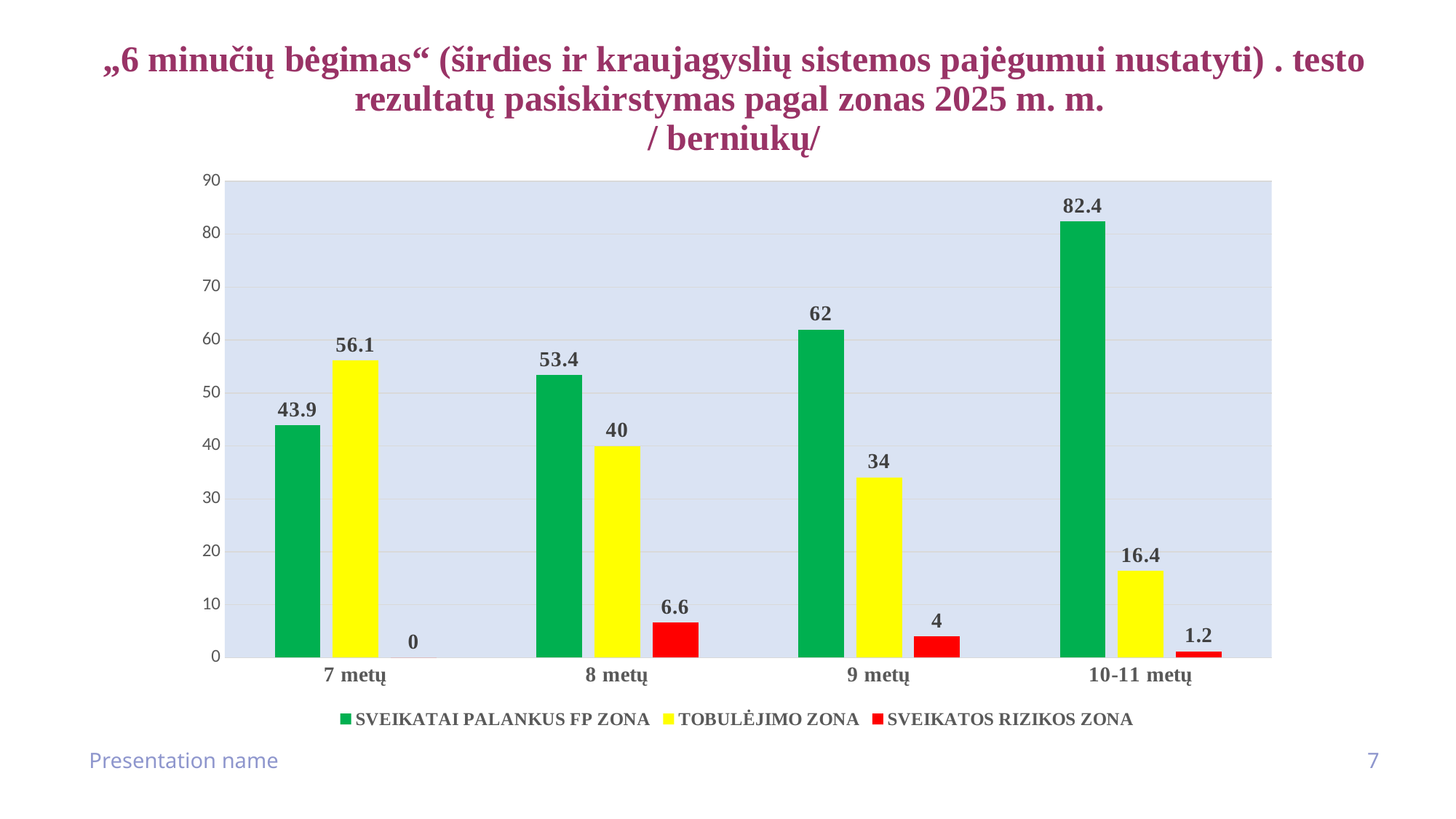
How many age groups are shown on the x axis? 4 How many series does the legend list? 3 What is the value for TOBULĖJIMO ZONA in the 7 metų group? 56.1 What kind of chart is shown on the slide? bar chart What is the value for SVEIKATAI PALANKUS FP ZONA in the 10-11 metų group? 82.4 Which age group has the lowest value for TOBULĖJIMO ZONA? 10-11 metų What is the difference between the SVEIKATAI PALANKUS FP ZONA values for 9 metų and 8 metų? 8.6 Does the value for SVEIKATAI PALANKUS FP ZONA rise or fall from 7 metų to 10-11 metų? rise Is the value for SVEIKATAI PALANKUS FP ZONA in the 9 metų group greater or less than 60? greater Which age group has the highest value for SVEIKATAI PALANKUS FP ZONA? 10-11 metų What is the value for SVEIKATOS RIZIKOS ZONA in the 8 metų group? 6.6 In the 7 metų group, which is larger: SVEIKATAI PALANKUS FP ZONA or TOBULĖJIMO ZONA? TOBULĖJIMO ZONA